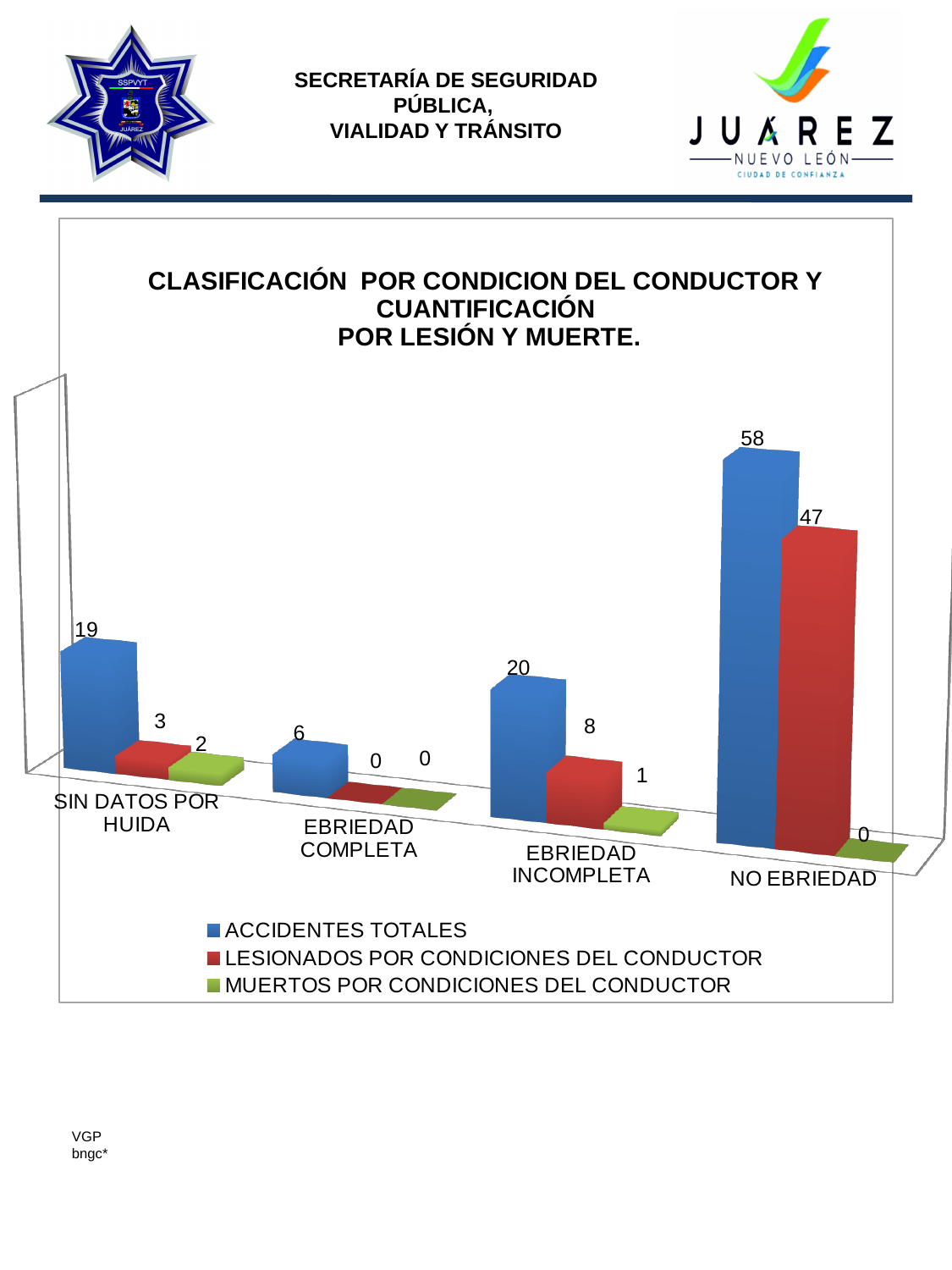
How many categories are shown on the x axis? 4 What is the value of LESIONADOS POR CONDICIONES DEL CONDUCTOR for EBRIEDAD INCOMPLETA? 8 What kind of chart is shown on the slide? Bar chart Which category has the lowest value for ACCIDENTES TOTALES? EBRIEDAD COMPLETA What is the difference between ACCIDENTES TOTALES and LESIONADOS POR CONDICIONES DEL CONDUCTOR for NO EBRIEDAD? 11 What is the value of MUERTOS POR CONDICIONES DEL CONDUCTOR for SIN DATOS POR HUIDA? 2 What is the value of LESIONADOS POR CONDICIONES DEL CONDUCTOR for EBRIEDAD COMPLETA? 0 Which is larger: ACCIDENTES TOTALES for SIN DATOS POR HUIDA or ACCIDENTES TOTALES for EBRIEDAD INCOMPLETA? EBRIEDAD INCOMPLETA How many series does the legend list? 3 What is the value of ACCIDENTES TOTALES for NO EBRIEDAD? 58 Which colour represents MUERTOS POR CONDICIONES DEL CONDUCTOR in the legend? Green Which category has the highest value for ACCIDENTES TOTALES? NO EBRIEDAD